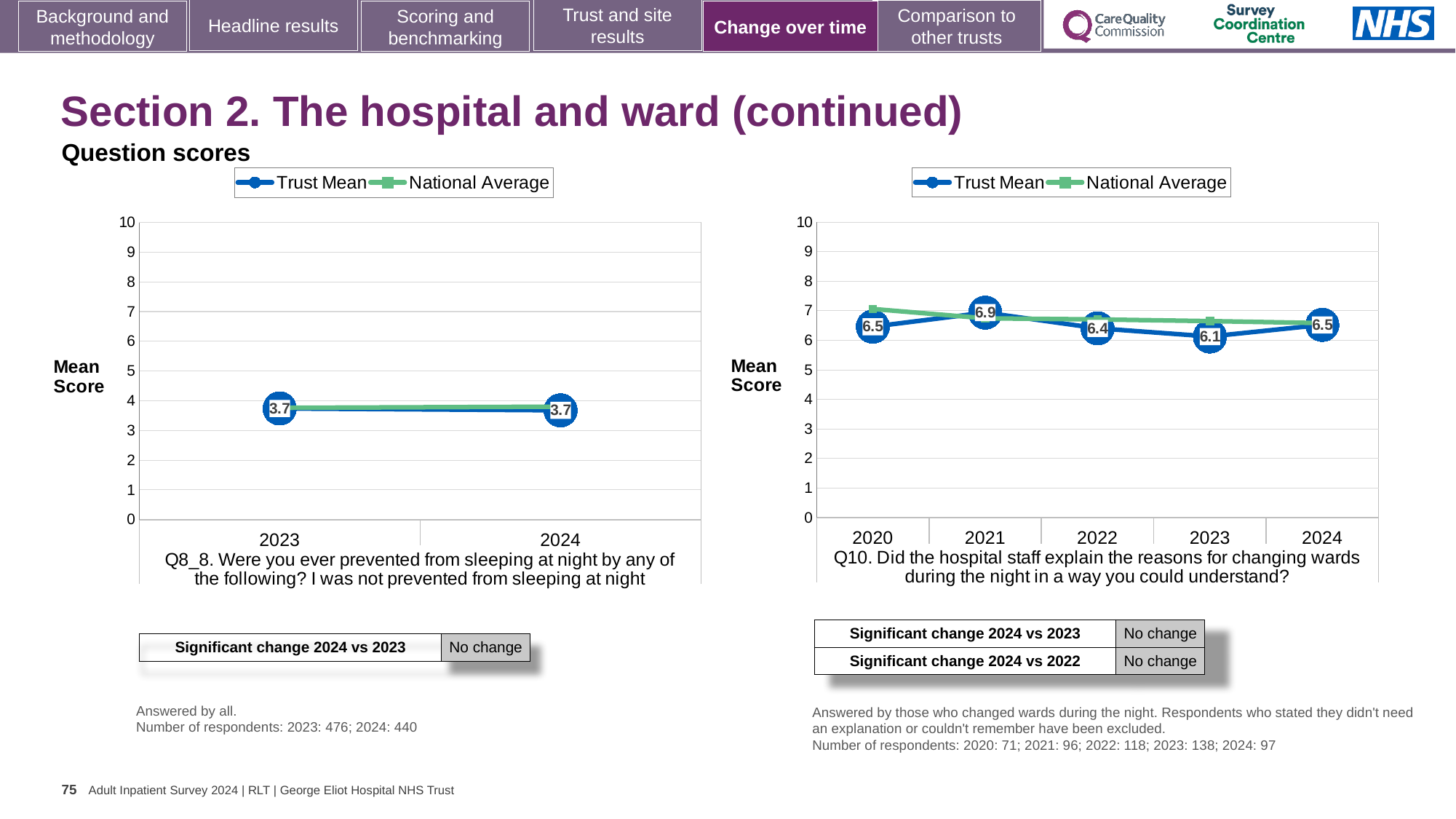
In the Q8_8 chart (left), what is the Trust Mean for 2023? 3.7 What type of chart is the Q10 chart (right)? Line chart In the Q10 chart (right), how many years are plotted on the x axis? 5 In the Q8_8 chart (left), is the Trust Mean for 2024 greater or less than 5? less In the Q10 chart (right), what is the difference between the Trust Mean for 2021 and the Trust Mean for 2023? 0.8 How many series does the legend of the Q10 chart (right) list? 2 In the Q10 chart (right), which year has the highest Trust Mean? 2021 In the Q8_8 chart (left), how many years are plotted on the x axis? 2 In the Q10 chart (right), what is the Trust Mean for 2023? 6.1 In the Q8_8 chart (left), what is the Trust Mean for 2024? 3.7 In the Q10 chart (right), what is the Trust Mean for 2021? 6.9 In the Q10 chart (right), which year has the lowest Trust Mean? 2023